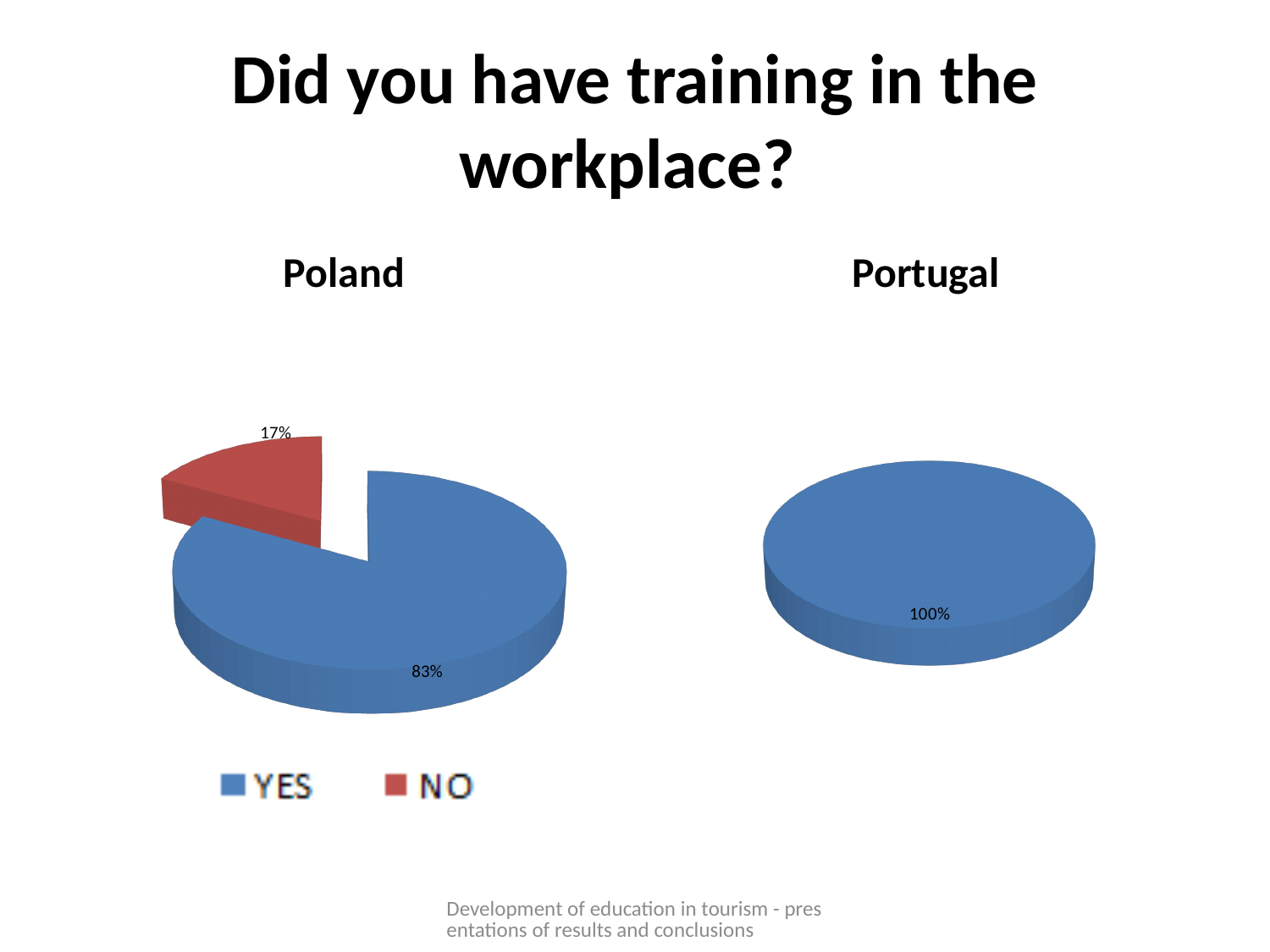
In the Poland chart, which is larger, the YES share or the NO share? YES In the Poland chart, which answer has the smallest share? NO In the Poland chart, which answer has the largest share? YES How many entries does the legend list? 2 In the Poland chart, what percentage of respondents answered YES? 83% What kind of chart is used for Poland? Pie chart Which colour represents NO in the legend? Red How many slices does the Poland pie chart have? 2 In the Poland chart, what is the difference in percentage points between the YES and NO shares? 66 Is the YES share in the Poland chart greater or less than 50%? greater In the Portugal chart, what percentage is shown for the single slice? 100% In the Poland chart, what percentage of respondents answered NO? 17%